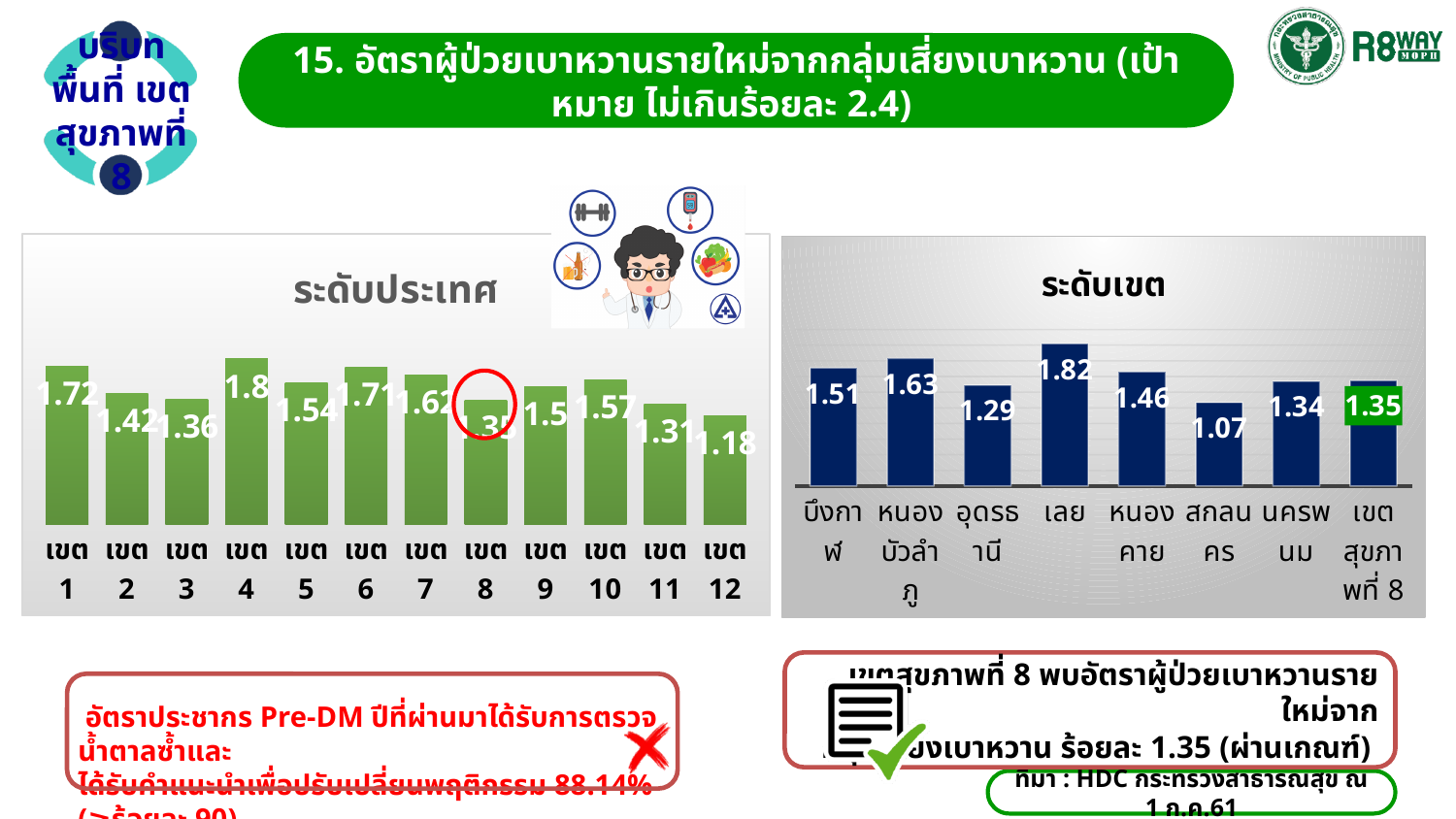
In the chart titled ระดับเขต, what is the value for เลย? 1.82 In the chart titled ระดับประเทศ, what is the difference between the values for เขต 4 and เขต 12? 0.62 In the chart titled ระดับประเทศ, what is the value for เขต 1? 1.72 In the chart titled ระดับประเทศ, how many เขต categories are shown? 12 In the chart titled ระดับเขต, which category has the highest value? เลย In the chart titled ระดับประเทศ, which เขต has the lowest value? เขต 12 In the chart titled ระดับเขต, what is the value for เขตสุขภาพที่ 8? 1.35 What type of chart is the chart titled ระดับเขต? bar chart In the chart titled ระดับประเทศ, which เขต has the highest value? เขต 4 In the chart titled ระดับประเทศ, which is larger, the value for เขต 6 or เขต 7? เขต 6 In the chart titled ระดับเขต, which category has the lowest value? สกลนคร In the chart titled ระดับเขต, what is the difference between the values for หนองบัวลำภู and อุดรธานี? 0.34